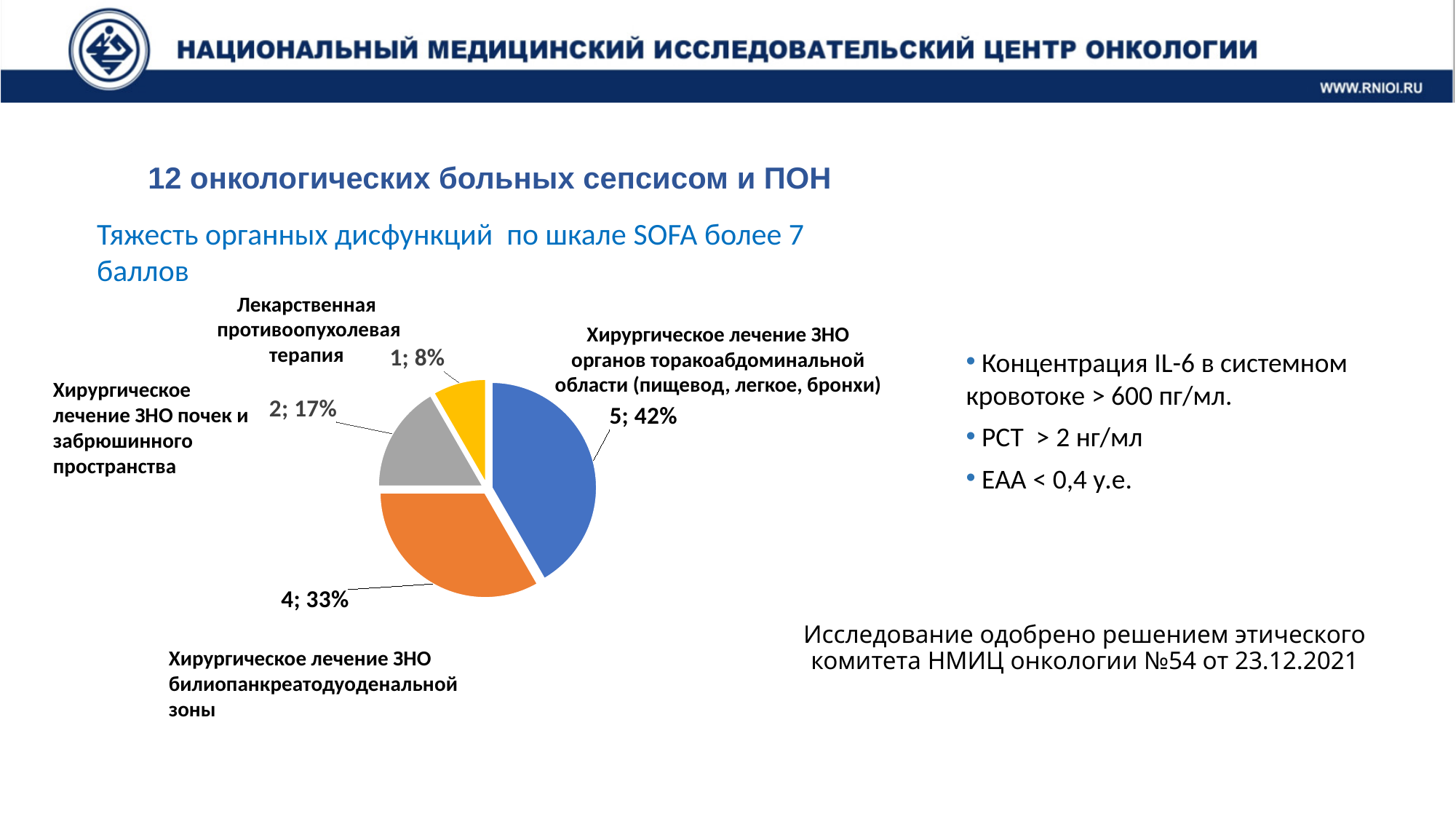
Which category has the smallest slice of the pie chart? Лекарственная противоопухолевая терапия What percentage share does the slice for surgical treatment of biliopancreatoduodenal zone malignancies (Хирургическое лечение ЗНО билиопанкреатодуоденальной зоны) have? 33% How many patients are in the slice for surgical treatment of kidney and retroperitoneal malignancies (Хирургическое лечение ЗНО почек и забрюшинного пространства)? 2 Which slice is larger: kidney/retroperitoneal surgery (Хирургическое лечение ЗНО почек и забрюшинного пространства) or drug antitumor therapy (Лекарственная противоопухолевая терапия)? Хирургическое лечение ЗНО почек и забрюшинного пространства How many patients are in the slice for surgical treatment of thoracoabdominal malignancies (Хирургическое лечение ЗНО органов торакоабдоминальной области)? 5 What kind of chart is shown on the slide? Pie chart What is the total number of patients across all slices of the pie chart? 12 How many slices does the pie chart have? 4 What percentage share does the slice for drug antitumor therapy (Лекарственная противоопухолевая терапия) have? 8% What colour is the slice for surgical treatment of biliopancreatoduodenal zone malignancies? Orange What is the difference in patient count between the thoracoabdominal surgery slice and the biliopancreatoduodenal surgery slice? 1 Which category has the largest slice of the pie chart? Хирургическое лечение ЗНО органов торакоабдоминальной области (пищевод, легкое, бронхи)